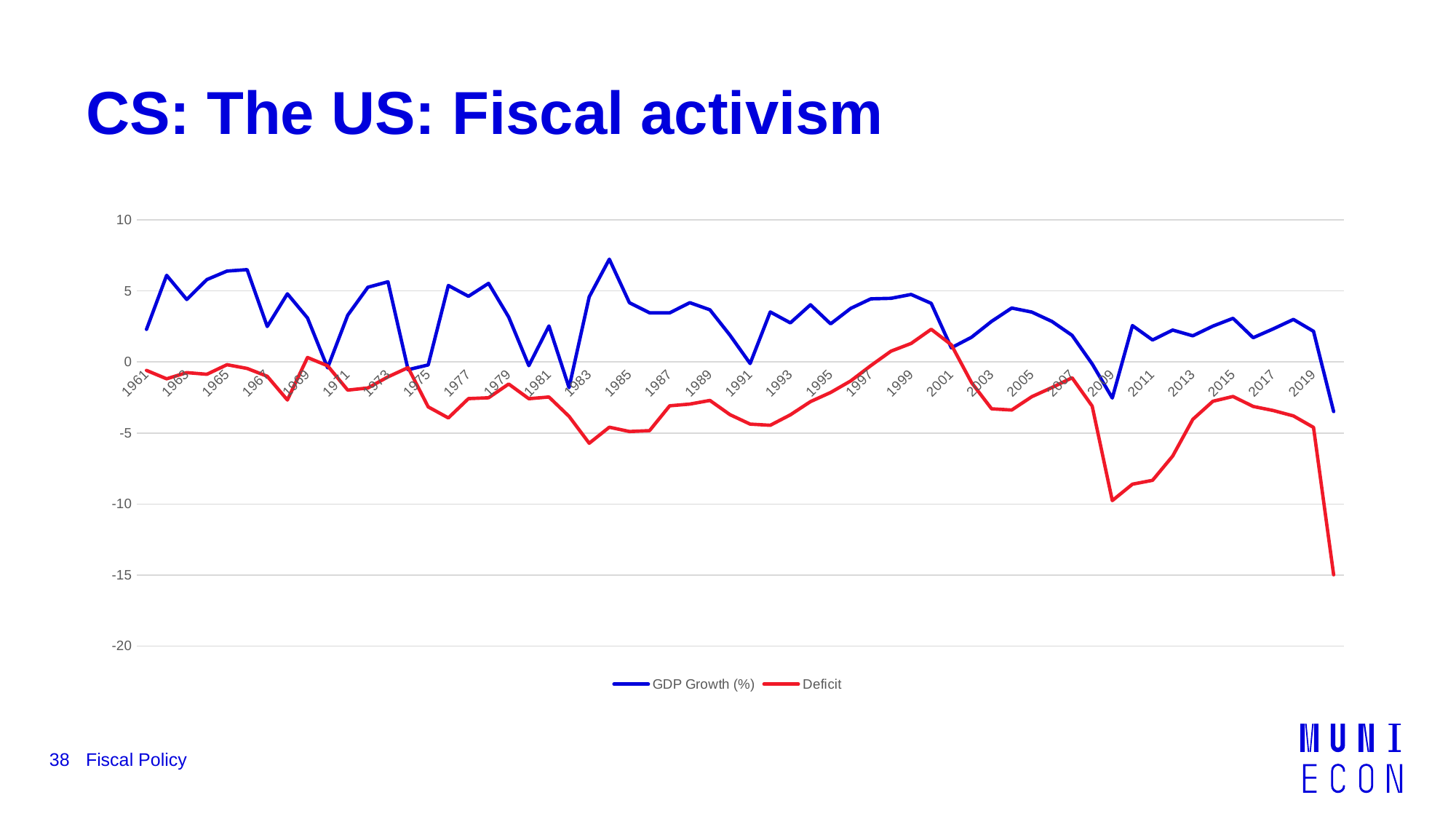
Does the Deficit line rise or fall between 2017 and the end of the series? fall Is the Deficit value for 2009 greater or less than -5? less Is the GDP Growth (%) value for 2009 greater or less than 0? less Is the GDP Growth (%) value for 1965 greater or less than 5? greater What are the two series named in the legend? GDP Growth (%) and Deficit Which colour is used for the Deficit line? red How many series does the legend list? 2 What kind of chart is shown on the slide? line chart Which series reaches the lowest value anywhere on the chart? Deficit In 2009, which is higher: GDP Growth (%) or Deficit? GDP Growth (%)